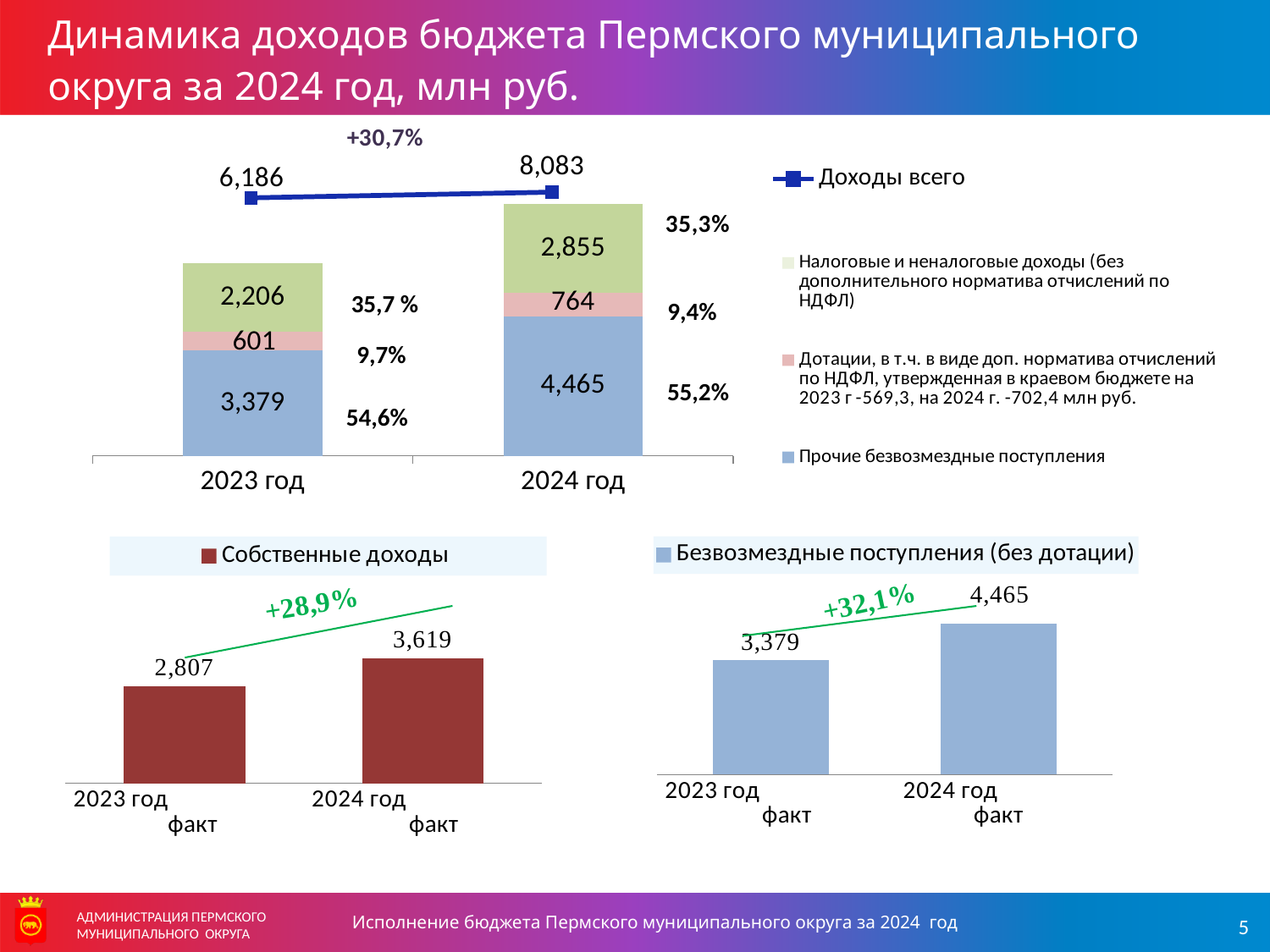
In the top chart, what percentage growth is shown between 2023 год and 2024 год for 'Доходы всего'? +30,7% What kind of chart is the 'Собственные доходы' chart? Bar chart In the top chart, what is the value of the 'Доходы всего' line for 2024 год? 8,083 In the top chart, how many series does the legend list? 4 In the top chart, what is the value of the 'Прочие безвозмездные поступления' segment for 2023 год? 3,379 In the 'Безвозмездные поступления (без дотации)' chart, what percentage growth is shown? +32,1% In the top chart, by how much does the 'Налоговые и неналоговые доходы' segment for 2024 год exceed that for 2023 год? 649 In the 'Безвозмездные поступления (без дотации)' chart, which year has the higher value? 2024 год факт In the top chart, what is the value of the 'Дотации' segment for 2024 год? 764 In the top chart, what is the total of the stacked bar for 2023 год? 6,186 In the 'Собственные доходы' chart, what is the difference between 2024 год факт and 2023 год факт? 812 In the 'Собственные доходы' chart, what is the value for 2024 год факт? 3,619